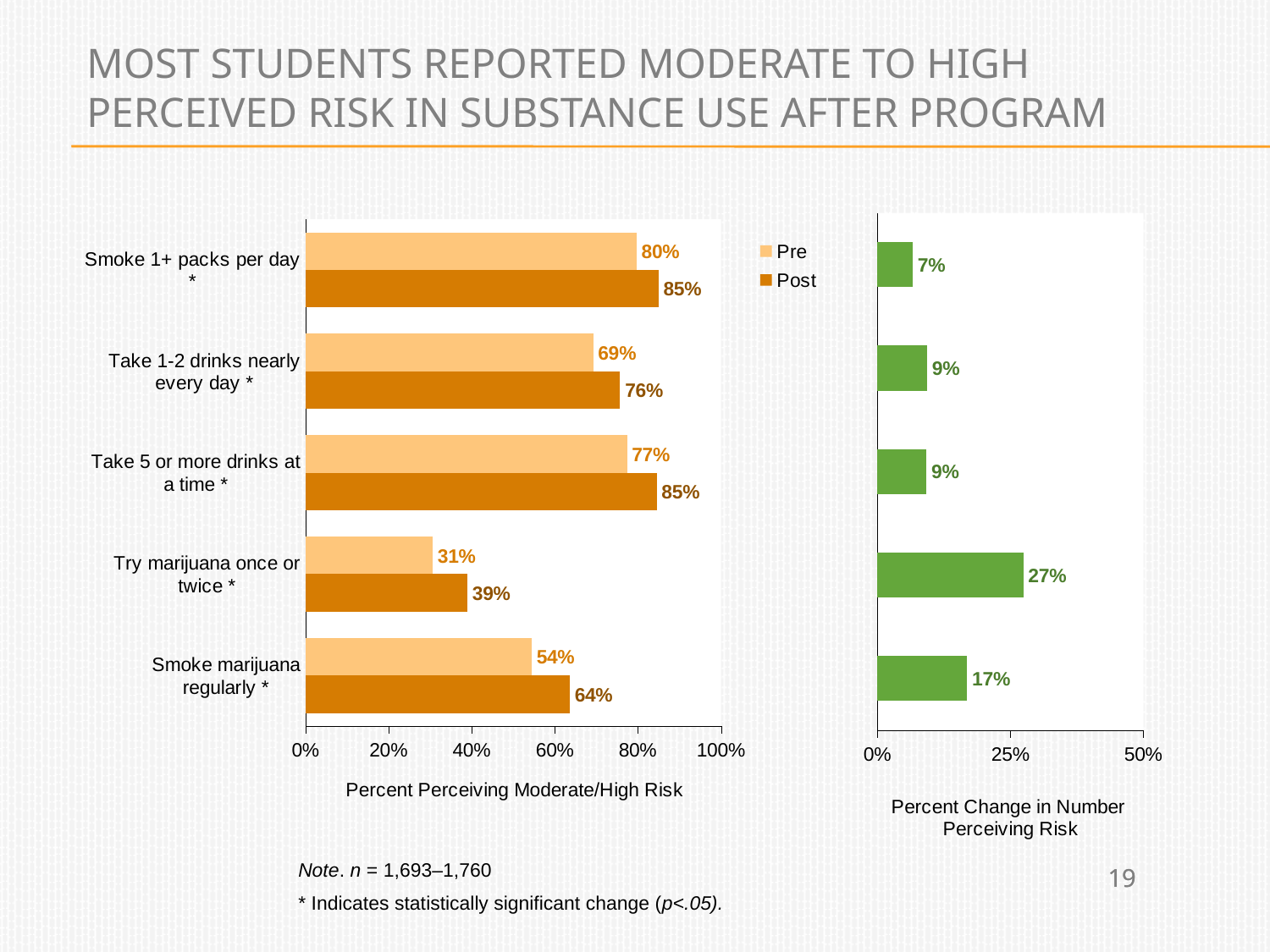
In the left chart (Percent Perceiving Moderate/High Risk), what is the Pre value for "Take 1-2 drinks nearly every day"? 69% What type of chart is the right chart (Percent Change in Number Perceiving Risk)? Bar chart In the right chart (Percent Change in Number Perceiving Risk), what is the value for "Try marijuana once or twice"? 27% In the left chart (Percent Perceiving Moderate/High Risk), which category has the lowest Pre value? Try marijuana once or twice In the right chart (Percent Change in Number Perceiving Risk), is the value for "Smoke marijuana regularly" greater or less than 25%? less How many series does the legend of the left chart (Percent Perceiving Moderate/High Risk) list? 2 In the left chart (Percent Perceiving Moderate/High Risk), which is larger: the Post value for "Smoke marijuana regularly" or the Post value for "Try marijuana once or twice"? Smoke marijuana regularly In the right chart (Percent Change in Number Perceiving Risk), which category has the highest value? Try marijuana once or twice In the left chart (Percent Perceiving Moderate/High Risk), what is the Post value for "Smoke marijuana regularly"? 64% How many categories are shown in the left chart (Percent Perceiving Moderate/High Risk)? 5 In the left chart (Percent Perceiving Moderate/High Risk), what is the difference between the Post and Pre values for "Take 5 or more drinks at a time"? 8% In the right chart (Percent Change in Number Perceiving Risk), which category has the lowest value? Smoke 1+ packs per day